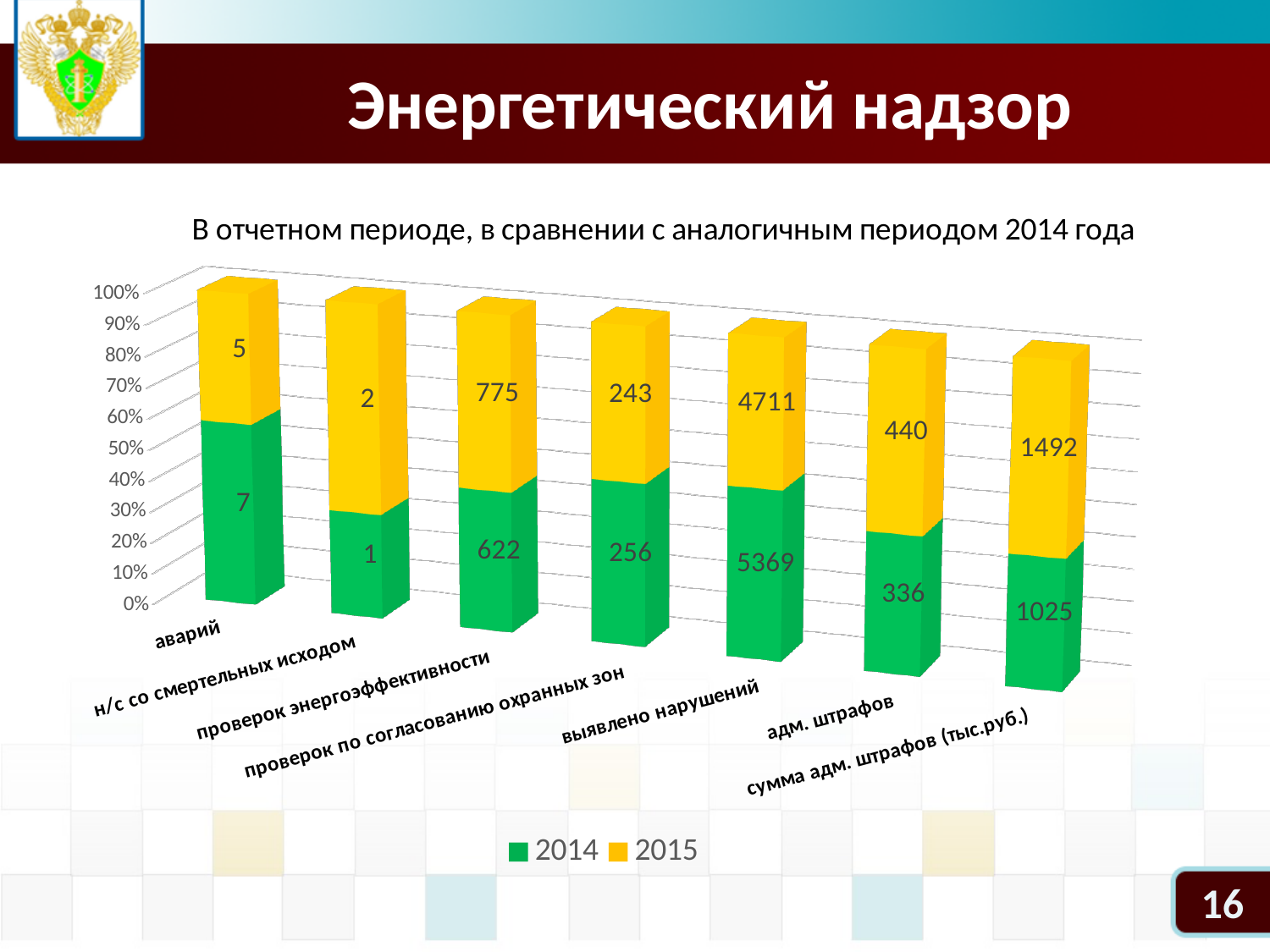
Which category has the lowest 2014 value? н/с со смертельных исходом What is the difference between the 2014 and 2015 values for "выявлено нарушений"? 658 What is the 2014 value for "адм. штрафов"? 336 How many series does the legend list? 2 What kind of chart is shown on the slide? Stacked bar chart What is the total of the 2014 and 2015 values for "аварий"? 12 Which category has the highest 2015 value? выявлено нарушений How many categories are shown on the x axis? 7 For "проверок по согласованию охранных зон", which year has the larger value, 2014 or 2015? 2014 What is the 2014 value for "выявлено нарушений"? 5369 What is the 2015 value for "проверок энергоэффективности"? 775 What is the 2015 value for "сумма адм. штрафов (тыс.руб.)"? 1492